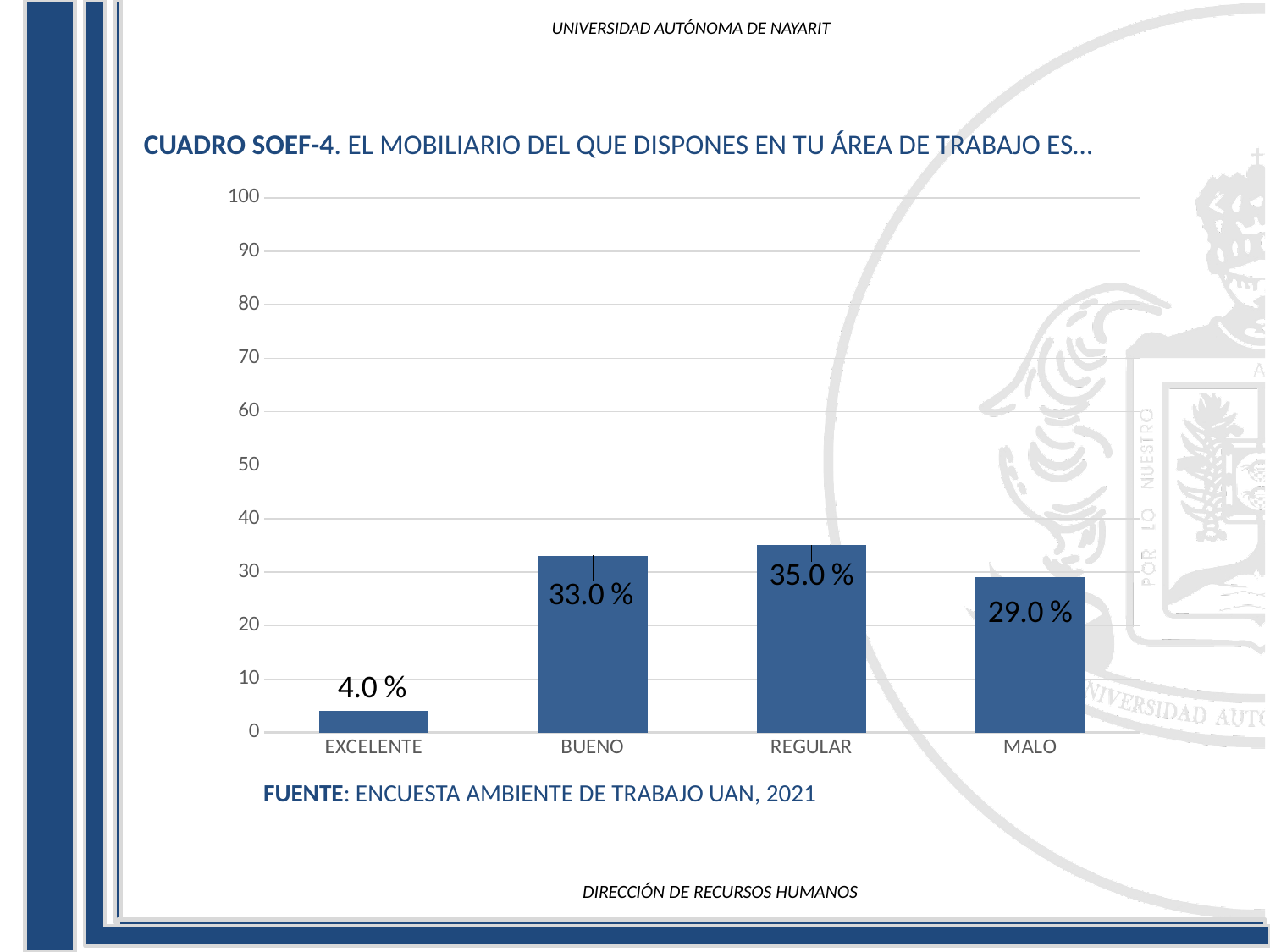
Which category has the highest value? REGULAR Which category has the lowest value? EXCELENTE Which is larger, the value for BUENO or the value for MALO? BUENO What is the value for BUENO? 33.0 % What is the value for REGULAR? 35.0 % What is the difference between the values for REGULAR and MALO? 6.0 % Is the value for MALO greater or less than 20? greater What is the value for MALO? 29.0 % What is the source cited below the chart? ENCUESTA AMBIENTE DE TRABAJO UAN, 2021 How many categories are shown on the x axis? 4 What kind of chart is shown on the slide? bar chart What is the value for EXCELENTE? 4.0 %